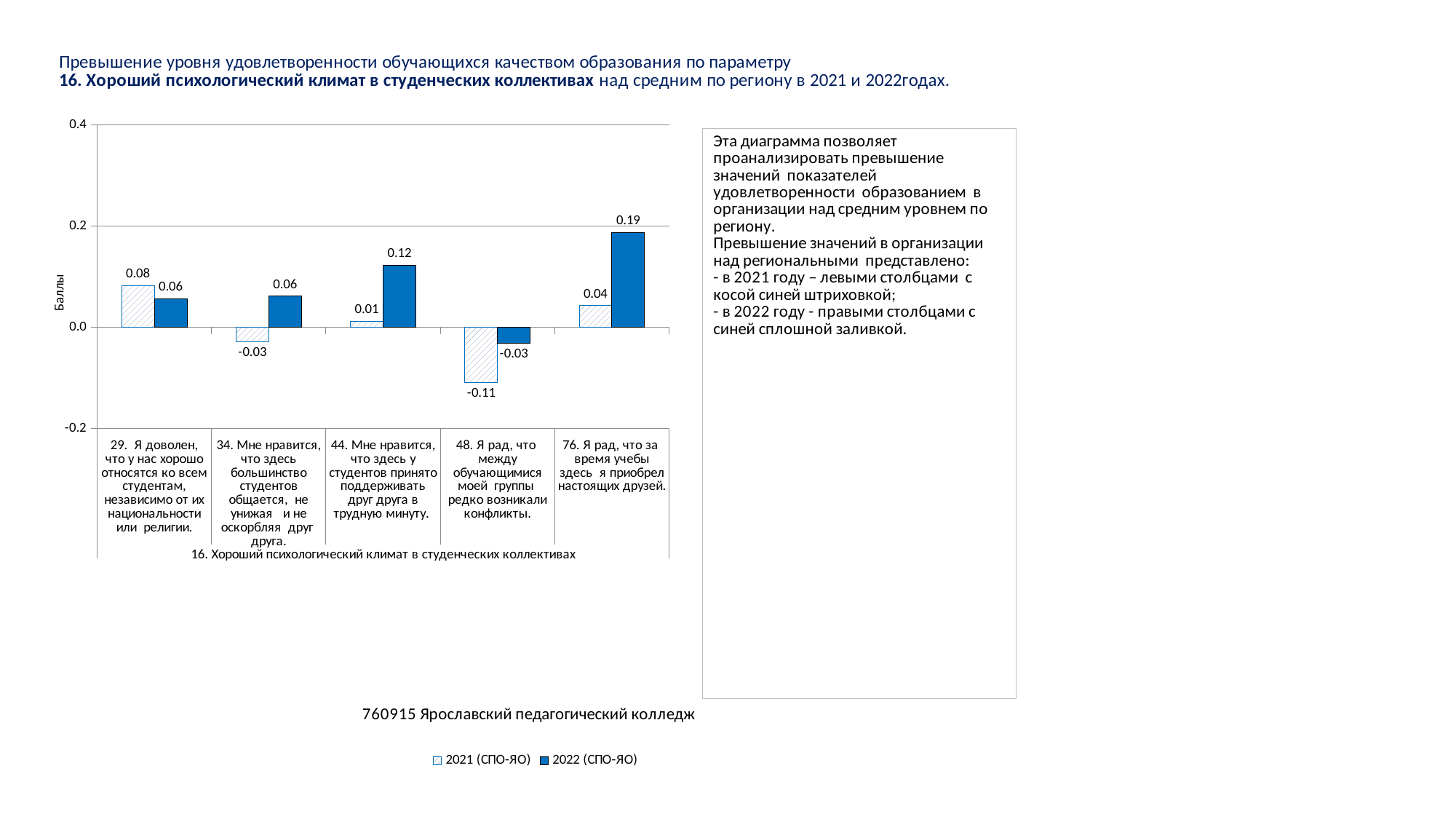
What is the difference between the 2022 (СПО-ЯО) and 2021 (СПО-ЯО) values for statement 48? 0.08 How many series does the chart legend list? 2 How many statements (categories) are shown on the x axis of the chart? 5 What is the value for 2022 (СПО-ЯО) for statement 76 (Я рад, что за время учебы здесь я приобрел настоящих друзей)? 0.19 What is the value for 2021 (СПО-ЯО) for statement 48 (Я рад, что между обучающимися моей группы редко возникали конфликты)? -0.11 For statement 29, which series has the larger value: 2021 (СПО-ЯО) or 2022 (СПО-ЯО)? 2021 (СПО-ЯО) Which statement has the lowest value for 2021 (СПО-ЯО)? 48. Я рад, что между обучающимися моей группы редко возникали конфликты. What is the difference between the 2022 (СПО-ЯО) and 2021 (СПО-ЯО) values for statement 76? 0.15 Which statement has the highest value for 2022 (СПО-ЯО)? 76. Я рад, что за время учебы здесь я приобрел настоящих друзей. What is the value for 2021 (СПО-ЯО) for statement 29 (Я доволен, что у нас хорошо относятся ко всем студентам)? 0.08 What is the value for 2022 (СПО-ЯО) for statement 44 (Мне нравится, что здесь у студентов принято поддерживать друг друга в трудную минуту)? 0.12 What kind of chart is shown on the slide? Bar chart